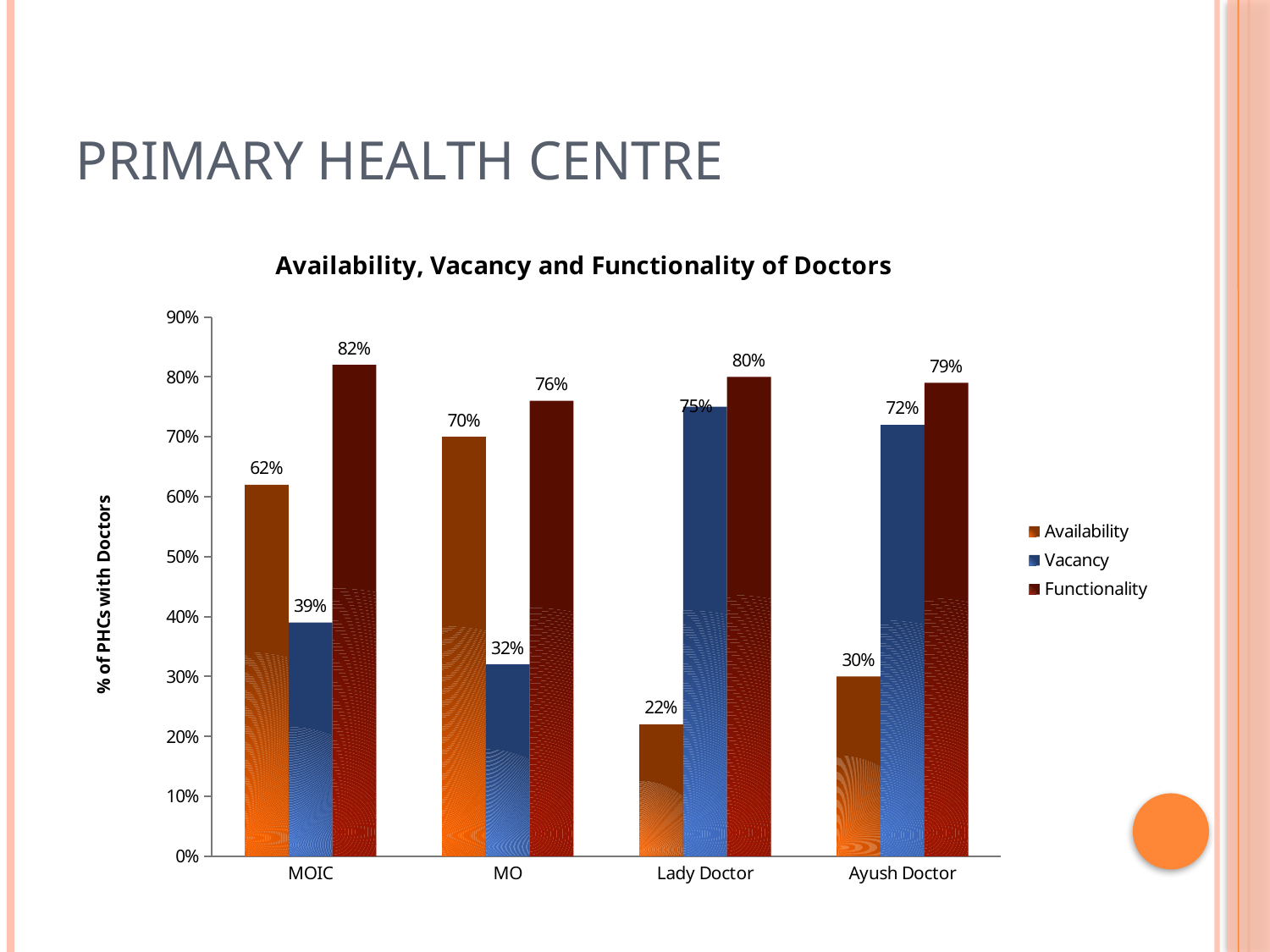
How many categories are shown on the x axis? 4 Which category has the lowest Availability value? Lady Doctor What is the Availability value for MOIC? 62% What is the difference between the Functionality and Availability values for MO? 6% Which is larger, the Vacancy value for MOIC or the Vacancy value for MO? MOIC What is the Functionality value for Ayush Doctor? 79% What kind of chart is shown on the slide? bar chart What is the title of the chart? Availability, Vacancy and Functionality of Doctors Is the Availability value for Ayush Doctor greater or less than 40%? less What is the Vacancy value for Lady Doctor? 75% How many series does the legend list? 3 Which category has the highest Functionality value? MOIC